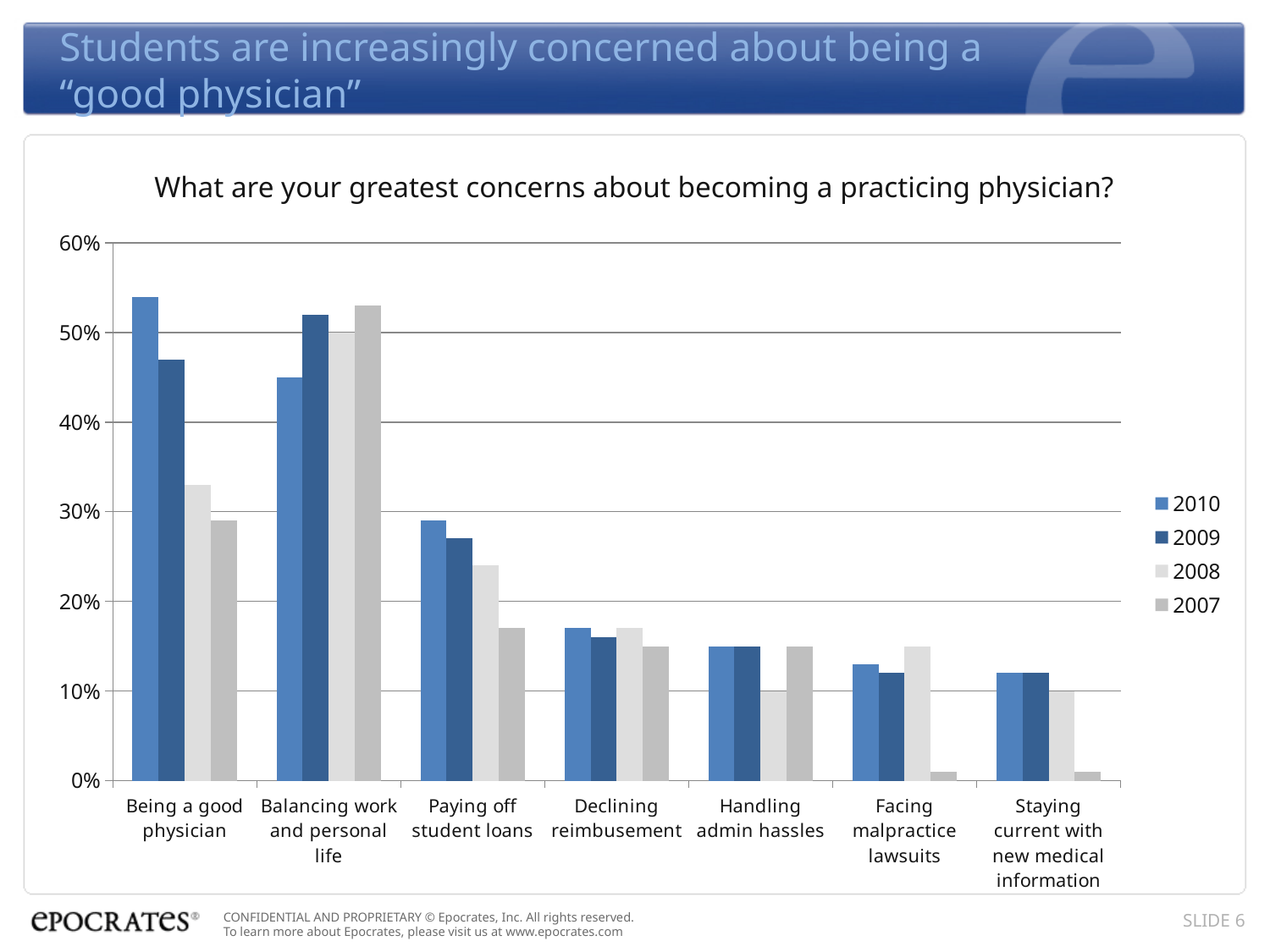
How many series does the legend list? 4 For "Balancing work and personal life", which is larger: the 2010 value or the 2007 value? 2007 Is the 2007 value for "Facing malpractice lawsuits" greater or less than 10%? less For "Being a good physician", which is larger: the 2010 value or the 2007 value? 2010 What kind of chart is shown on the slide? Bar chart Is the 2010 value for "Being a good physician" greater or less than 50%? greater What is the title of the chart? What are your greatest concerns about becoming a practicing physician? Is the 2008 value for "Being a good physician" greater or less than 30%? greater How many concern categories are shown on the x axis? 7 Which category has the highest 2010 value? Being a good physician For "Being a good physician", do the values increase or decrease from 2007 to 2010? increase